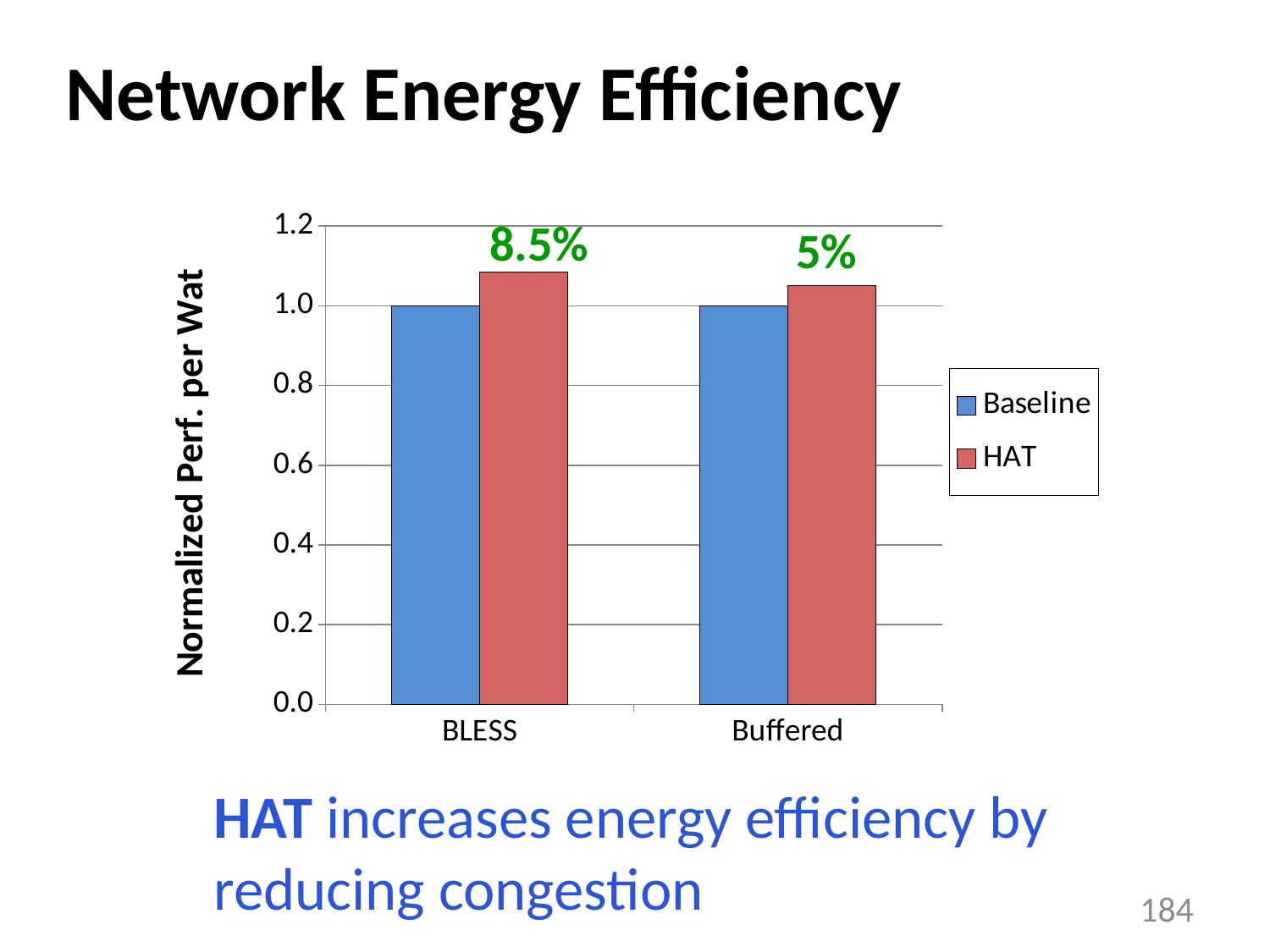
What percentage improvement is printed above the BLESS bars? 8.5% What is the Baseline value for BLESS? 1.0 What is the y-axis label of the chart? Normalized Perf. per Wat How many categories are shown on the x axis? 2 Is the HAT value for BLESS greater or less than 1.0? greater What is the Baseline value for Buffered? 1.0 What percentage improvement is printed above the Buffered bars? 5% What are the two series listed in the legend? Baseline and HAT Which category has the higher HAT value, BLESS or Buffered? BLESS What type of chart is shown on the slide? bar chart How many series does the legend list? 2 For Buffered, which is larger: the Baseline value or the HAT value? HAT